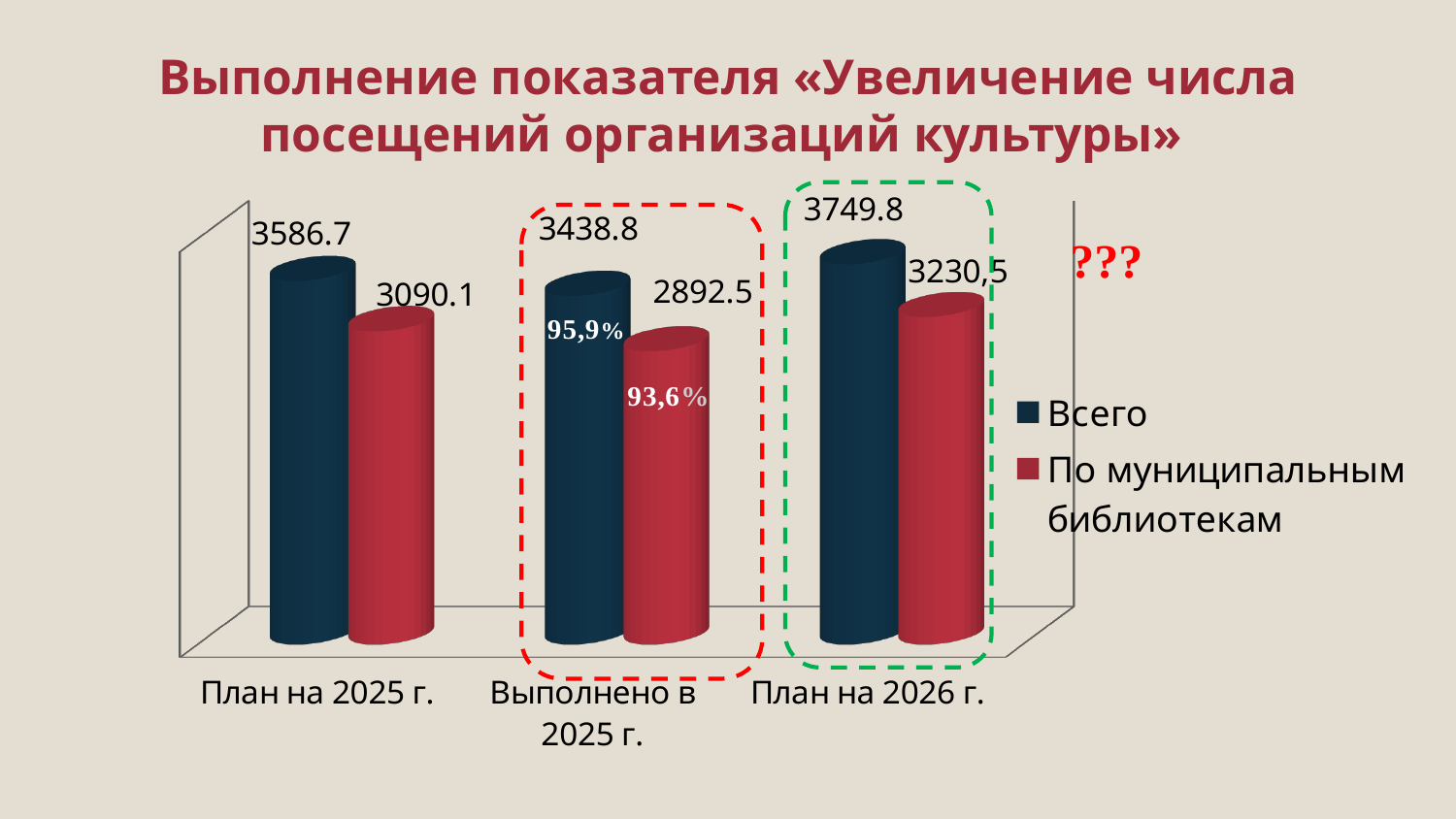
What kind of chart is shown on the slide? Bar chart What is the difference between the «Всего» values for «План на 2025 г.» and «Выполнено в 2025 г.»? 147.9 What is the value of the «Всего» series for «План на 2025 г.»? 3586.7 What percentage label is shown on the «Всего» bar for «Выполнено в 2025 г.»? 95,9% Which category has the lowest value for the «По муниципальным библиотекам» series? Выполнено в 2025 г. What is the value of the «По муниципальным библиотекам» series for «План на 2026 г.»? 3230,5 Which category has the highest value for the «Всего» series? План на 2026 г. What is the value of the «По муниципальным библиотекам» series for «Выполнено в 2025 г.»? 2892.5 How many series does the legend list? 2 Which is larger: the «Всего» value for «План на 2025 г.» or for «Выполнено в 2025 г.»? План на 2025 г. How many categories are shown on the x axis? 3 What is the value of the «Всего» series for «План на 2026 г.»? 3749.8